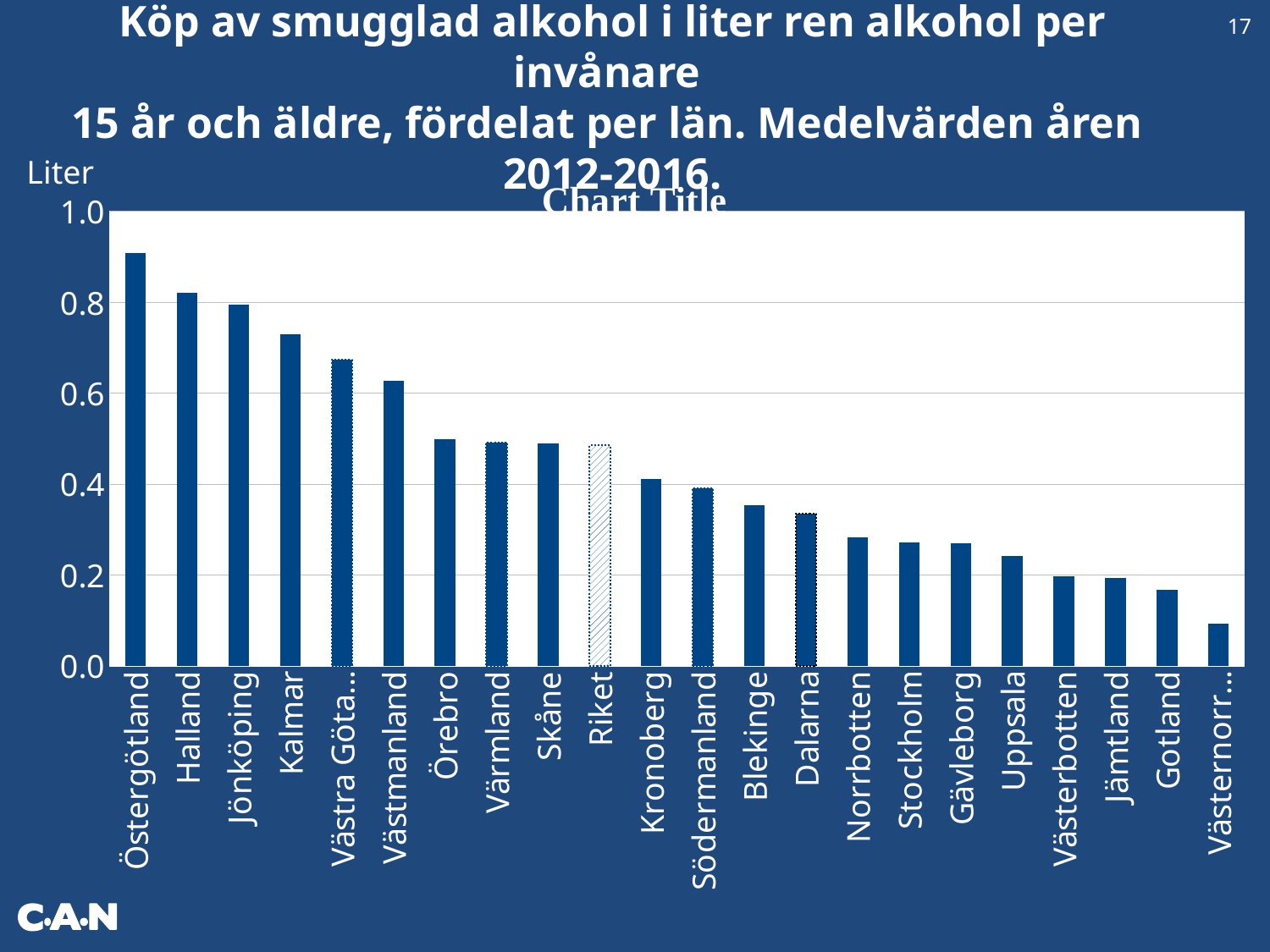
How many bars (län plus Riket) are plotted in the chart? 22 Is the value for Kalmar greater or less than 0.6? greater Do the values rise or fall from left to right along the x axis? fall What kind of chart is shown on the slide? bar chart Which has the larger value, Riket or Kronoberg? Riket Is the value for Riket greater or less than 0.6? less Is the value for Blekinge greater or less than 0.4? less What unit is shown above the vertical axis of the chart? Liter Which category has the highest value in the chart? Östergötland Which has the larger value, Kalmar or Västmanland? Kalmar